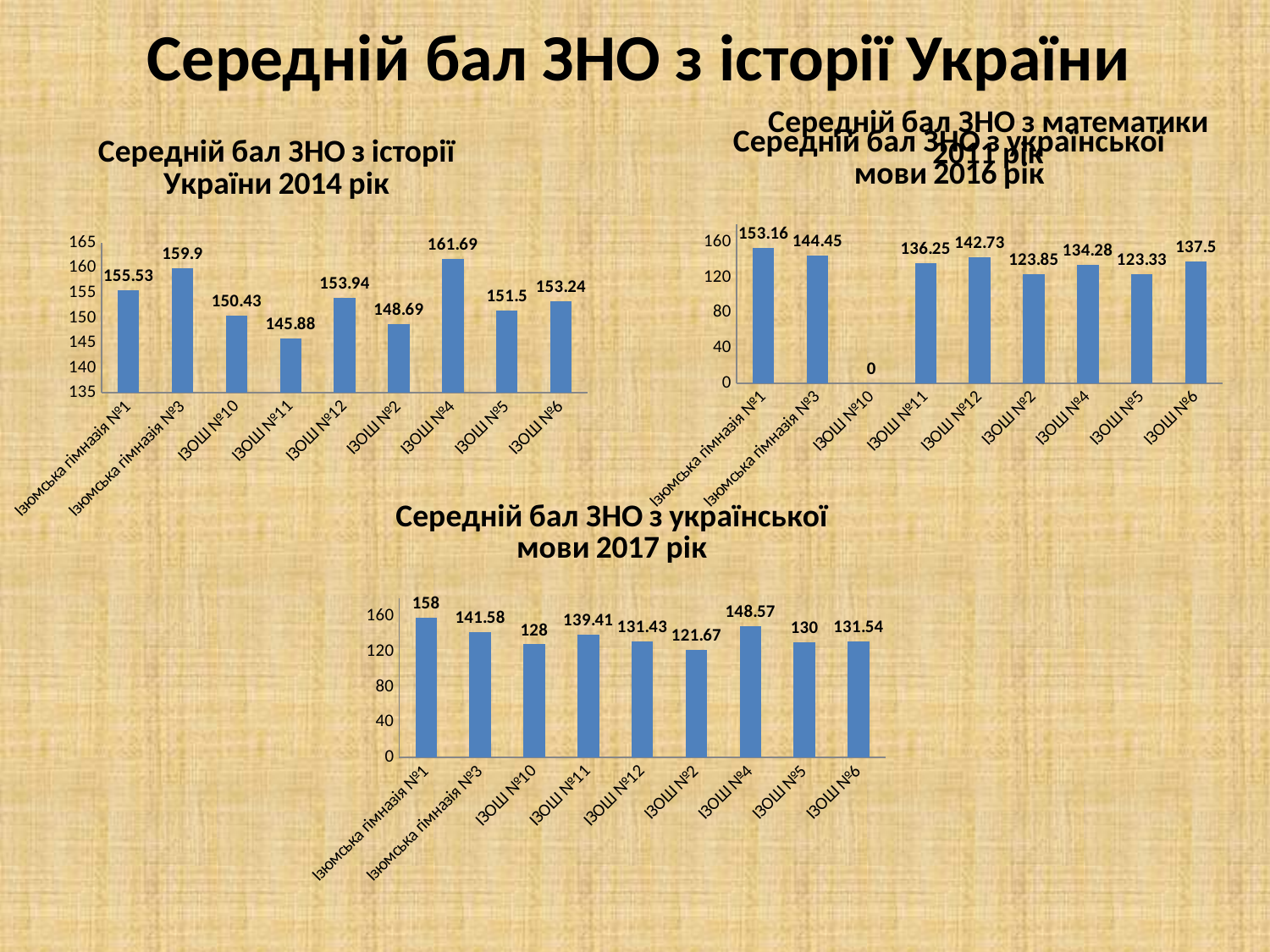
In the bottom chart (Середній бал ЗНО з української мови 2017 рік), which category has the lowest value? ІЗОШ №2 In the top-left chart (Середній бал ЗНО з історії України 2014 рік), how many categories are shown on the x axis? 9 In the top-right chart, what is the value for ІЗОШ №6? 137.5 What kind of chart is the bottom chart (Середній бал ЗНО з української мови 2017 рік)? Bar chart In the top-left chart (Середній бал ЗНО з історії України 2014 рік), what is the value for ІЗОШ №4? 161.69 In the top-right chart, which is larger: the value for ІЗОШ №12 or the value for ІЗОШ №2? ІЗОШ №12 In the top-left chart (Середній бал ЗНО з історії України 2014 рік), which category has the lowest value? ІЗОШ №11 In the top-right chart, which category has the highest value? Ізюмська гімназія №1 In the bottom chart (Середній бал ЗНО з української мови 2017 рік), what is the difference between the values for Ізюмська гімназія №1 and ІЗОШ №10? 30 In the top-right chart, what is the value for ІЗОШ №10? 0 In the top-left chart (Середній бал ЗНО з історії України 2014 рік), what is the difference between the values for ІЗОШ №4 and ІЗОШ №11? 15.81 In the bottom chart (Середній бал ЗНО з української мови 2017 рік), what is the value for Ізюмська гімназія №3? 141.58